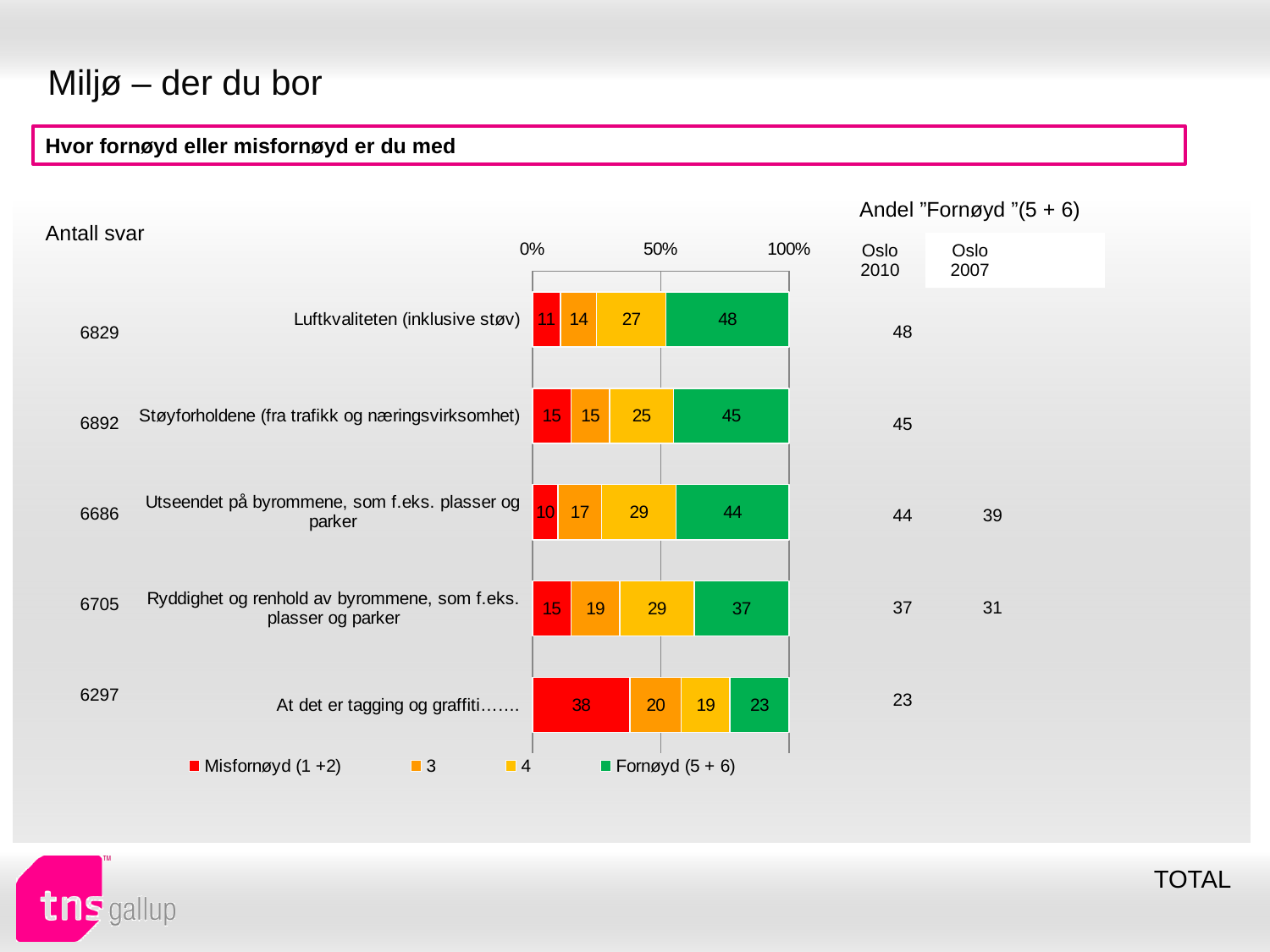
What is the value of series "3" for "Ryddighet og renhold av byrommene, som f.eks. plasser og parker"? 19 How many categories are shown in the chart? 5 What is the value of series "4" for "Støyforholdene (fra trafikk og næringsvirksomhet)"? 25 What is the value of the "Fornøyd (5 + 6)" series for "Luftkvaliteten (inklusive støv)"? 48 What is the value of the "Misfornøyd (1 +2)" series for "At det er tagging og graffiti……."? 38 Which is larger: the "Misfornøyd (1 +2)" value for "Utseendet på byrommene, som f.eks. plasser og parker" or for "Støyforholdene (fra trafikk og næringsvirksomhet)"? Støyforholdene (fra trafikk og næringsvirksomhet) Which category has the highest value for the "Fornøyd (5 + 6)" series? Luftkvaliteten (inklusive støv) How many series does the legend list? 4 What is the total of the stacked bar for "At det er tagging og graffiti……."? 100 Which category has the lowest value for the "Fornøyd (5 + 6)" series? At det er tagging og graffiti……. What kind of chart is shown on the slide? Stacked bar chart What is the difference between the "Fornøyd (5 + 6)" values for "Luftkvaliteten (inklusive støv)" and "At det er tagging og graffiti……."? 25